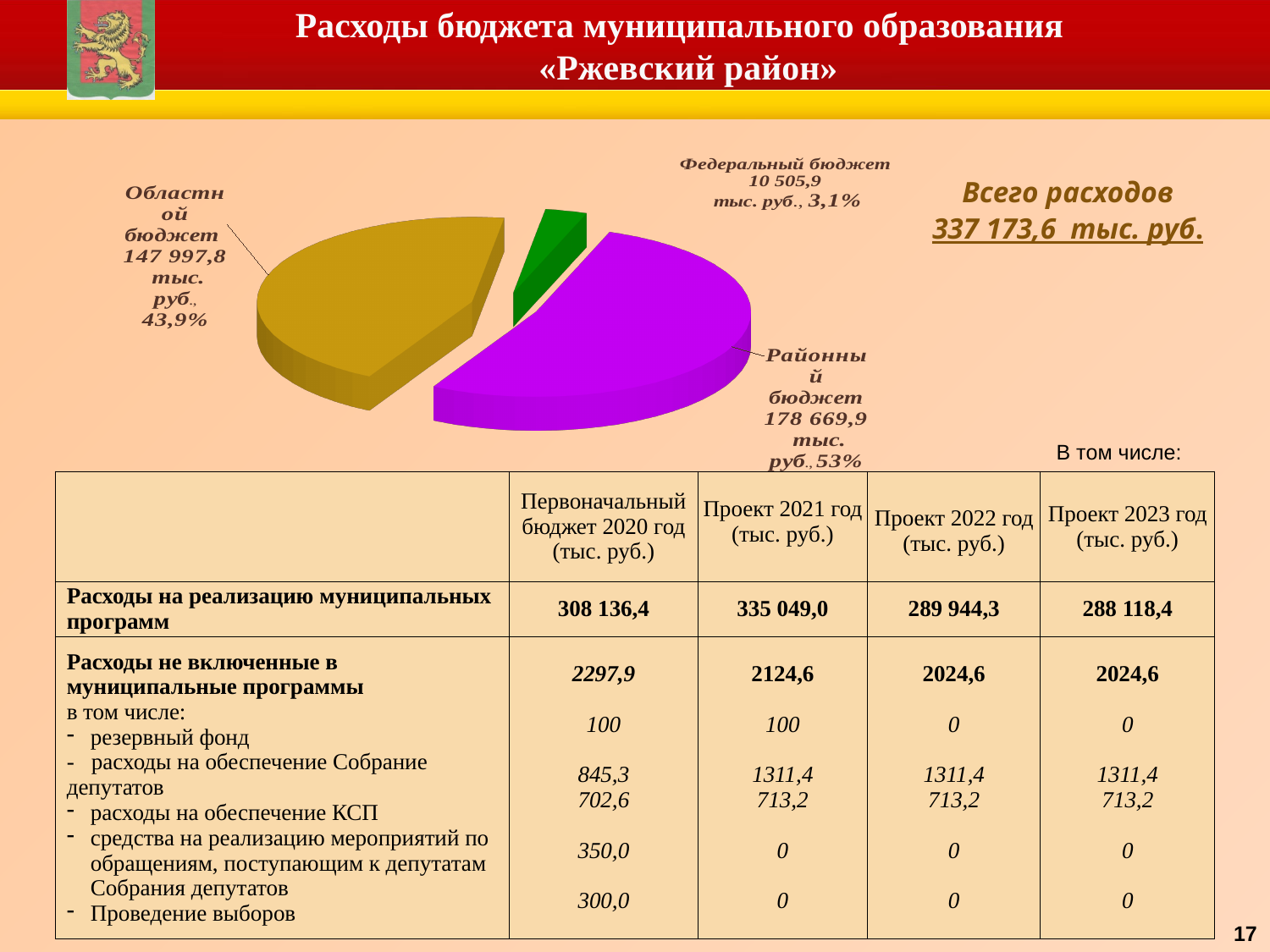
What kind of chart is shown on the slide? pie chart What share of the pie does Федеральный бюджет represent? 3,1% What share of the pie does Районный бюджет represent? 53% What is the value for Районный бюджет in the pie chart? 178 669,9 тыс. руб. Which is larger in the pie chart, Областной бюджет or Районный бюджет? Районный бюджет What share of the pie does Областной бюджет represent? 43,9% What is the value for Федеральный бюджет in the pie chart? 10 505,9 тыс. руб. What is the value for Областной бюджет in the pie chart? 147 997,8 тыс. руб. Which slice of the pie chart is the smallest? Федеральный бюджет How many slices does the pie chart have? 3 What is the difference between the Районный бюджет and Областной бюджет values in the pie chart? 30 672,1 тыс. руб. Which slice of the pie chart is the largest? Районный бюджет